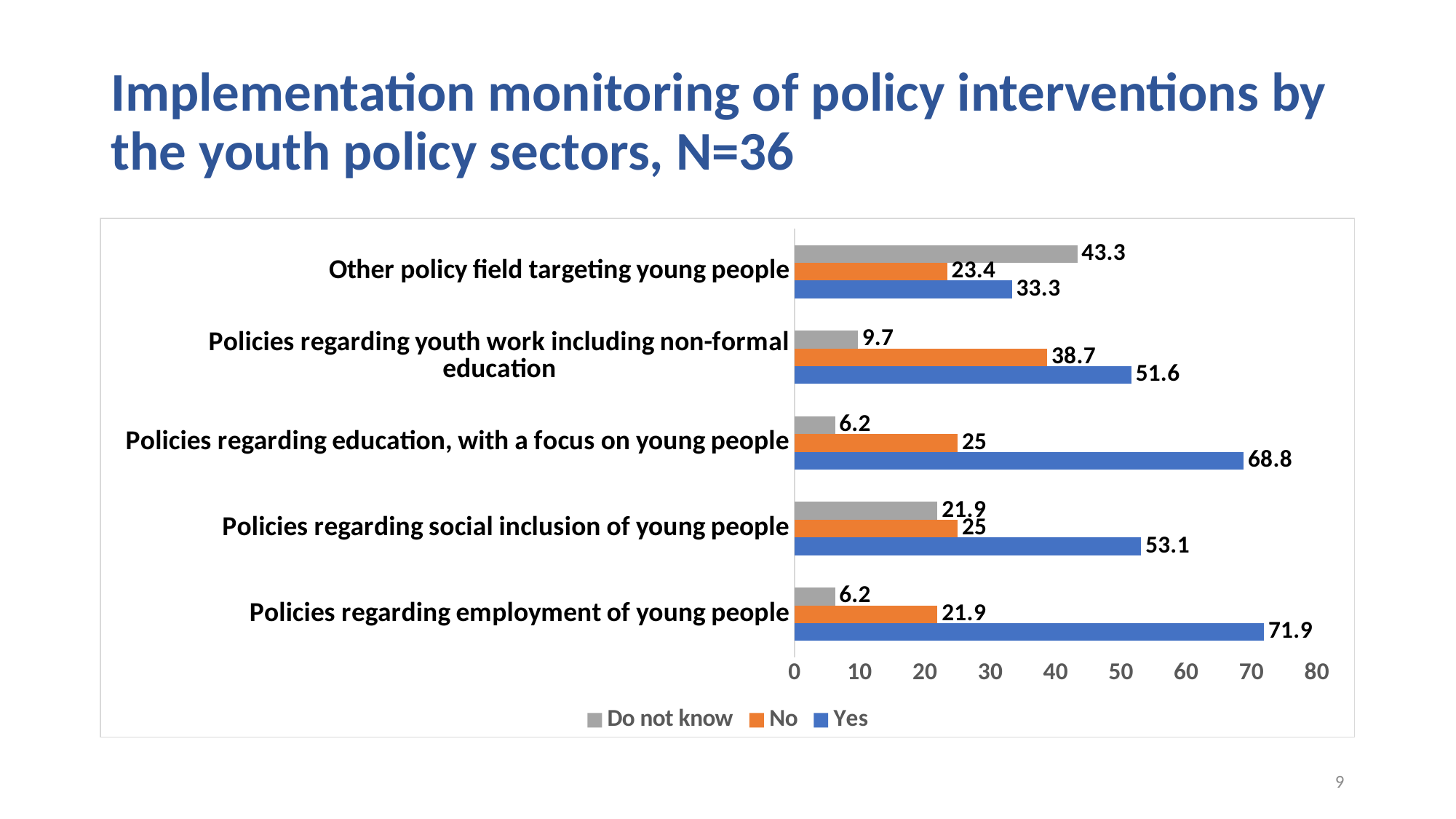
What is the 'Yes' value for Policies regarding employment of young people? 71.9 How many policy categories are shown on the chart? 5 What kind of chart is shown on the slide? Bar chart Which series is shown in orange? No What is the 'Do not know' value for Policies regarding social inclusion of young people? 21.9 What is the 'No' value for Policies regarding youth work including non-formal education? 38.7 Which is larger: the 'No' value for Other policy field targeting young people or the 'No' value for Policies regarding employment of young people? Other policy field targeting young people Which category has the highest 'Yes' value? Policies regarding employment of young people What is the 'Do not know' value for Other policy field targeting young people? 43.3 How many series does the legend list? 3 What is the difference between the 'Yes' values for Policies regarding education, with a focus on young people and Policies regarding social inclusion of young people? 15.7 Which category has the lowest 'Yes' value? Other policy field targeting young people